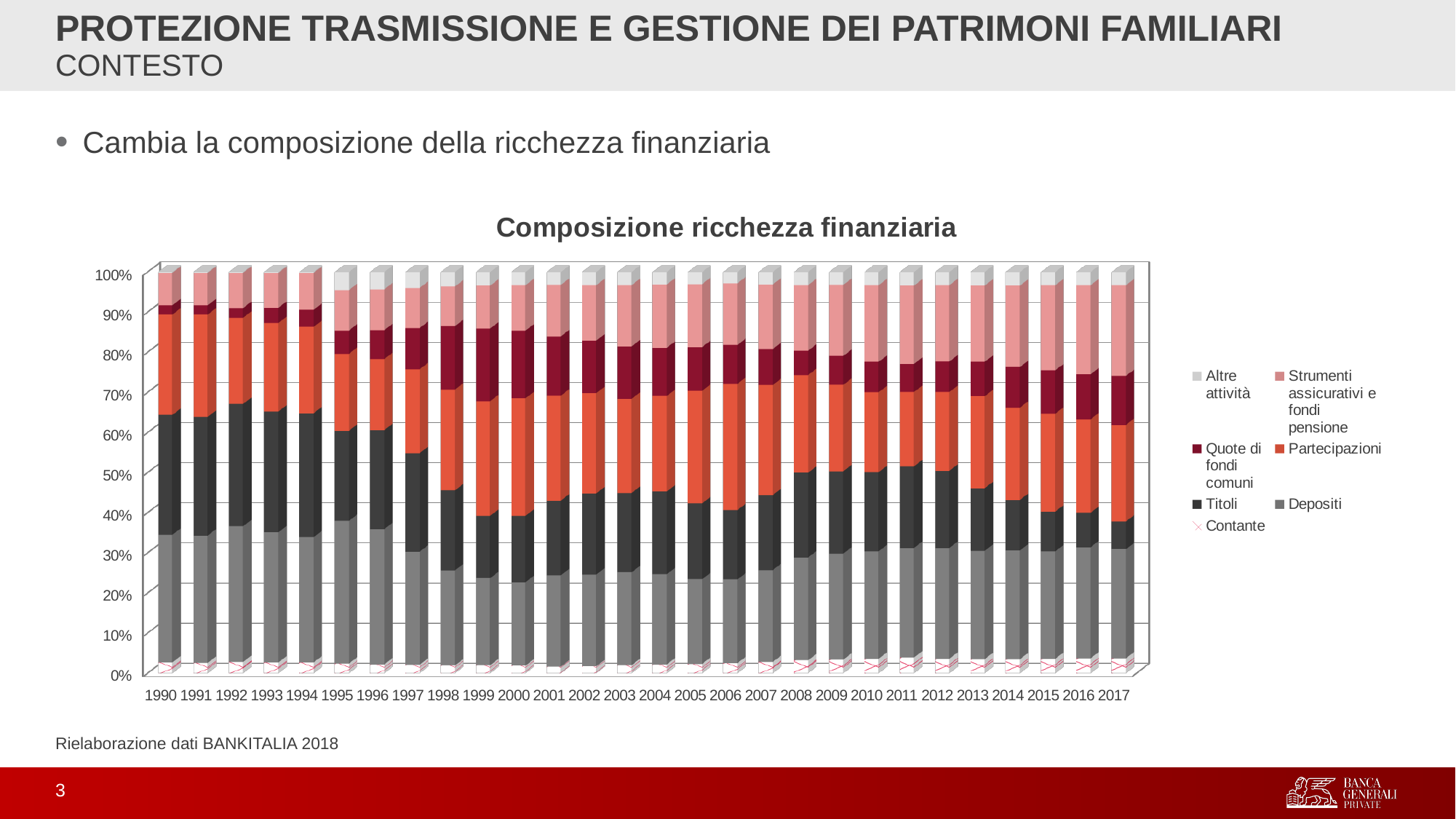
In 1990, is the top of the Titoli segment greater or less than 60%? greater Does the share of Titoli rise or fall from 1990 to 2017? Fall Which is the first year and which is the last year shown on the x axis? 1990 and 2017 How many years are shown along the x axis of the chart? 28 In 1990, is the top of the Partecipazioni segment greater or less than 80%? greater Is the Strumenti assicurativi e fondi pensione segment larger in 1990 or in 2017? 2017 What kind of chart is shown on the slide? Stacked bar chart Does the share of Strumenti assicurativi e fondi pensione rise or fall from 1990 to 2017? Rise Is the Titoli segment larger in 1990 or in 2017? 1990 How many series does the chart legend list? 7 In 2017, is the top of the Titoli segment greater or less than 50%? less What is the title of the chart? Composizione ricchezza finanziaria